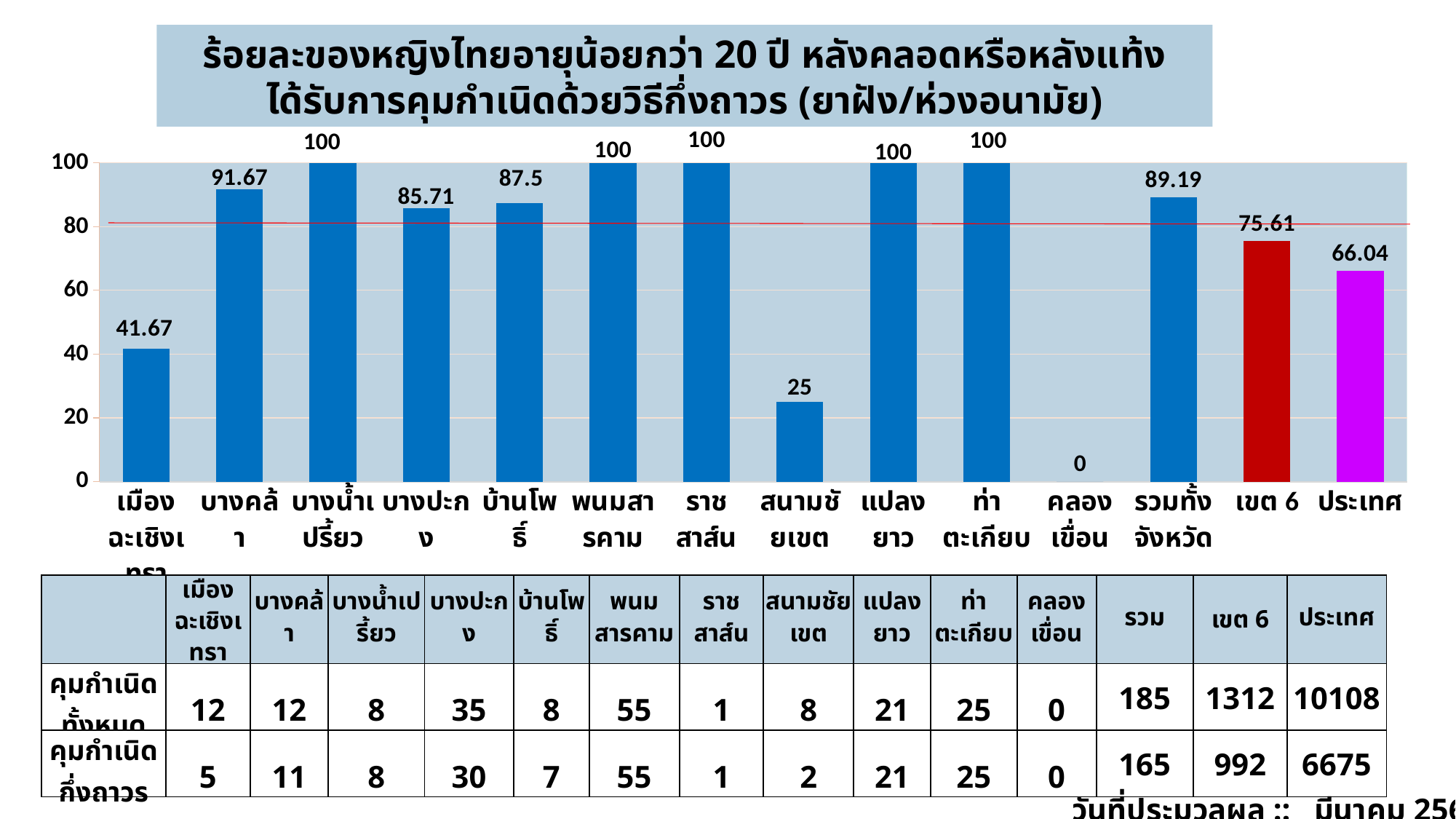
What is the value for รวมทั้งจังหวัด? 89.19 Which category has the lowest value? คลองเขื่อน What is the difference between the values for บ้านโพธิ์ and บางปะกง? 1.79 What is the value for บางคล้า? 91.67 Is the value for ประเทศ greater or less than 80? less What kind of chart is shown on the slide? bar chart How many categories have a value of 100? 5 What is the value for เขต 6? 75.61 How many categories are shown on the x axis of the chart? 14 What colour is the bar for เขต 6? red Which is larger, the value for เมืองฉะเชิงเทรา or the value for สนามชัยเขต? เมืองฉะเชิงเทรา What is the value for ประเทศ? 66.04